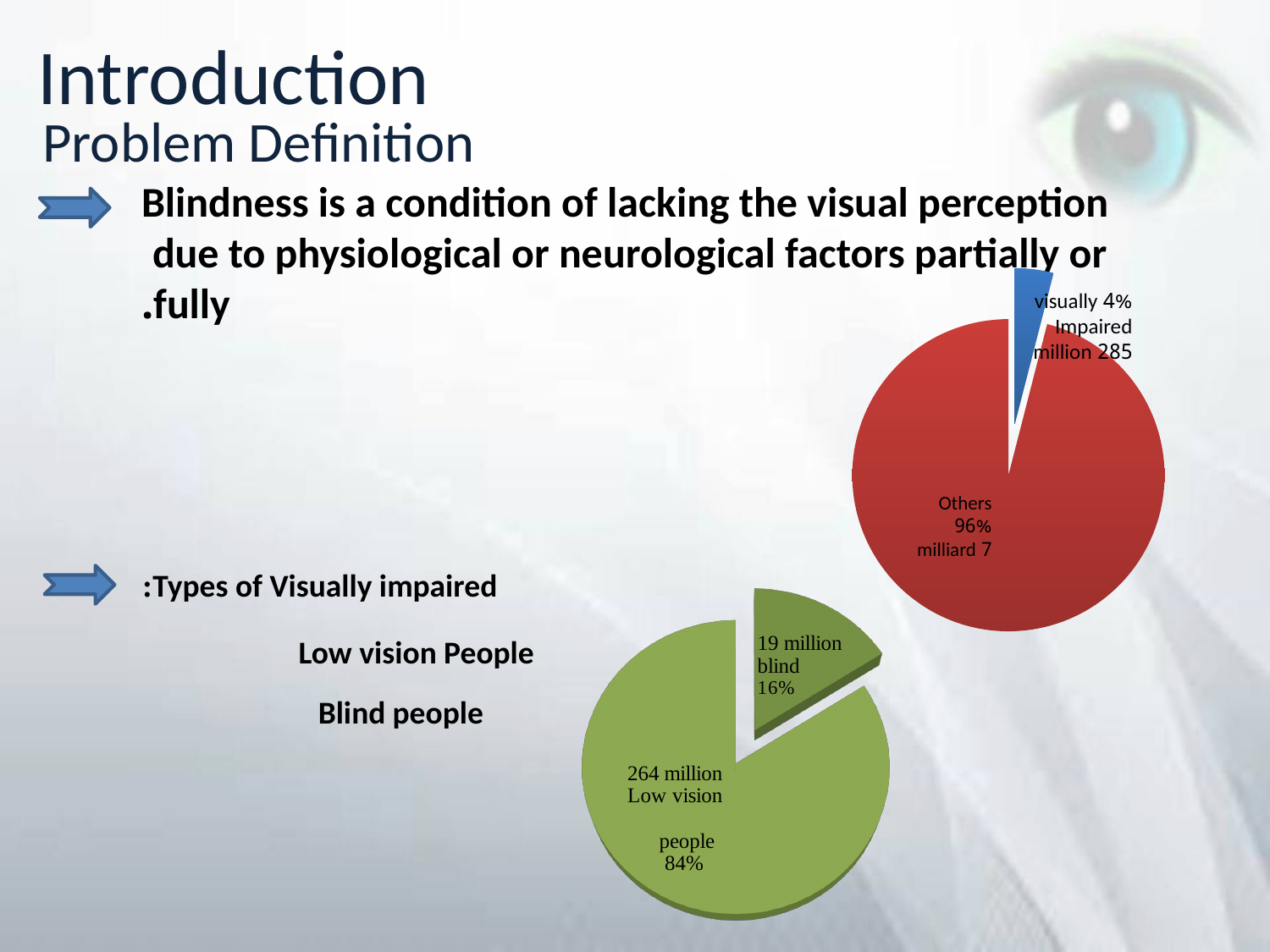
In the upper-right red and blue pie chart, what percentage is labelled for the visually impaired slice? 4% In the upper-right red and blue pie chart, which slice is the largest? Others In the lower green pie chart, how many million blind people are shown? 19 million In the upper-right pie chart, what colour is the visually impaired slice? Blue In the lower green pie chart, which slice is larger: blind or low vision people? Low vision people What kind of chart is the green chart at the bottom of the slide? Pie chart In the lower green pie chart, how many million low vision people are shown? 264 million In the lower green pie chart, what percentage share is labelled for low vision people? 84% In the lower green pie chart, what percentage share is labelled for blind people? 16% In the lower green pie chart, what is the difference in percentage points between the low vision and blind slices? 68 How many slices does the lower green pie chart have? 2 In the upper-right red and blue pie chart, what percentage is labelled for the Others slice? 96%